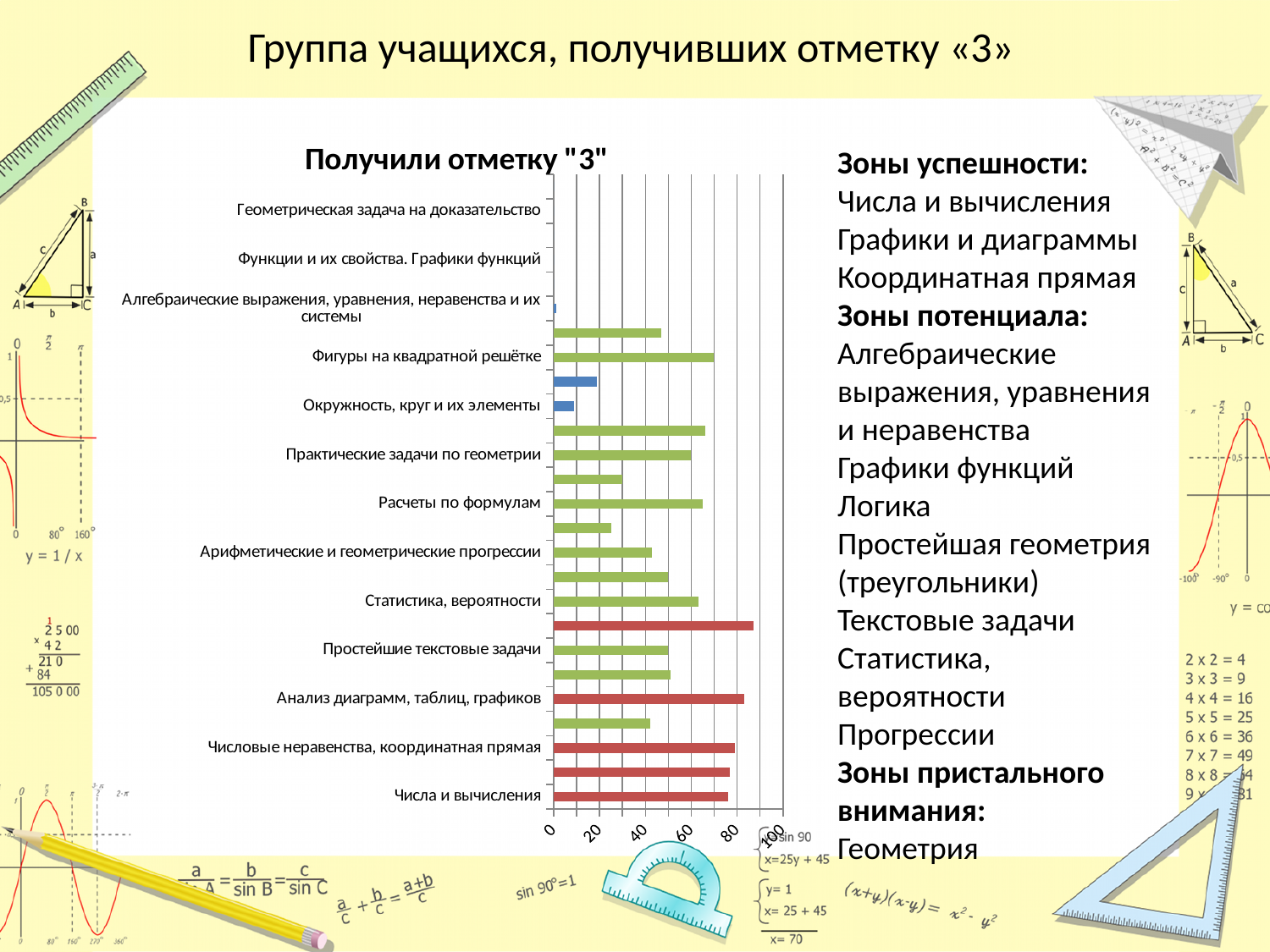
Which has a larger value: Анализ диаграмм, таблиц, графиков or Арифметические и геометрические прогрессии? Анализ диаграмм, таблиц, графиков Is the value for Статистика, вероятности greater or less than 40? greater Is the value for Анализ диаграмм, таблиц, графиков greater or less than 80? greater Is the value for Арифметические и геометрические прогрессии greater or less than 60? less What colour is the bar for Числа и вычисления? red Which has a larger value: Фигуры на квадратной решётке or Простейшие текстовые задачи? Фигуры на квадратной решётке What type of chart is shown on the slide? bar chart What is the title of the chart? Получили отметку "3" Which has a larger value: Числа и вычисления or Окружность, круг и их элементы? Числа и вычисления